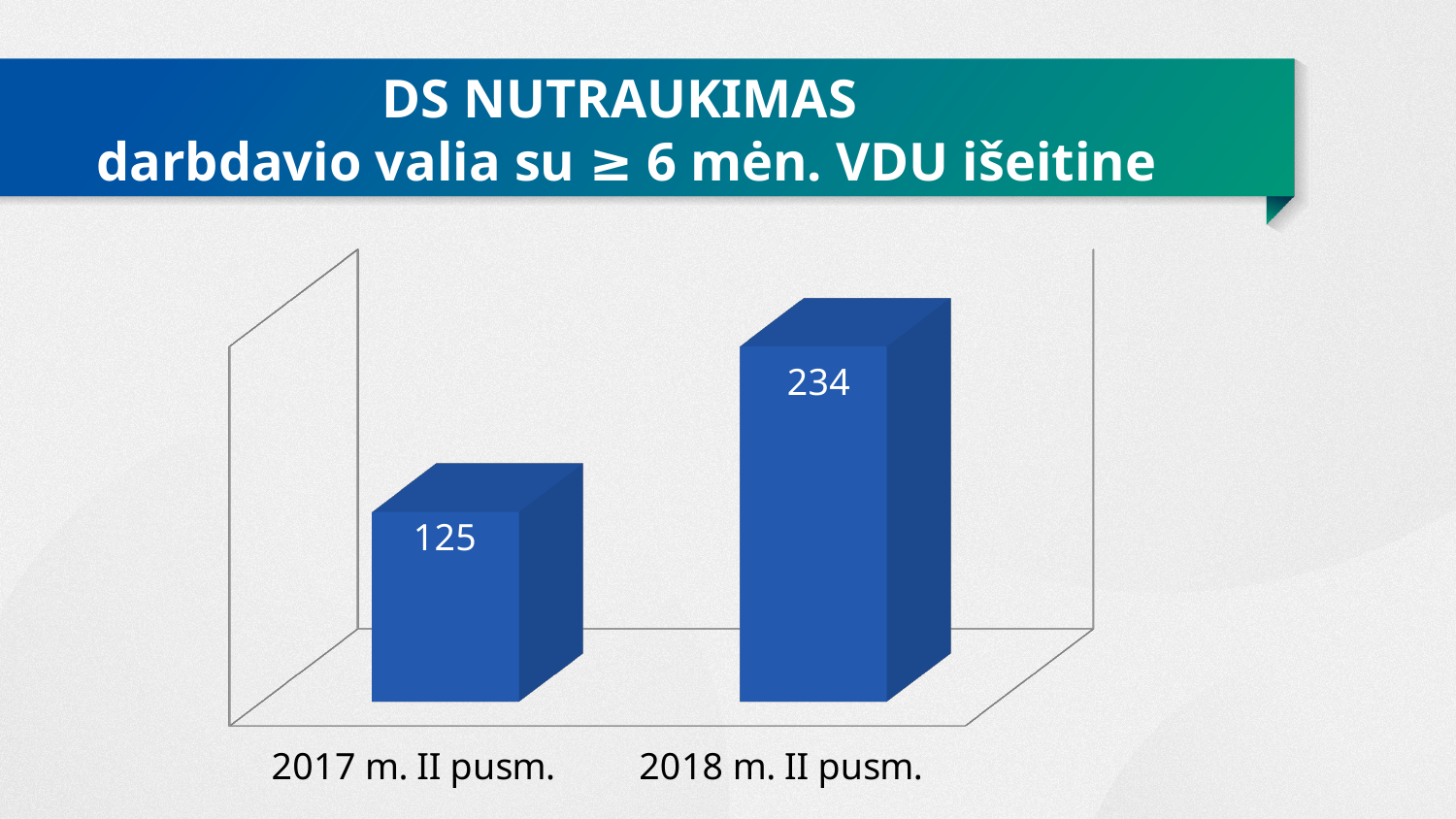
What is the value for 2017 m. II pusm.? 125 Which is larger, the value for 2017 m. II pusm. or the value for 2018 m. II pusm.? 2018 m. II pusm. What is the title shown on the slide above the chart? DS NUTRAUKIMAS darbdavio valia su ≥ 6 mėn. VDU išeitine What is the difference between the values for 2018 m. II pusm. and 2017 m. II pusm.? 109 What kind of chart is shown on the slide? Bar chart What is the value for 2018 m. II pusm.? 234 How many categories are shown in the chart? 2 Which category has the highest value? 2018 m. II pusm. Which category has the lowest value? 2017 m. II pusm. Do the values rise or fall from 2017 m. II pusm. to 2018 m. II pusm.? Rise What colour are the bars in the chart? Blue